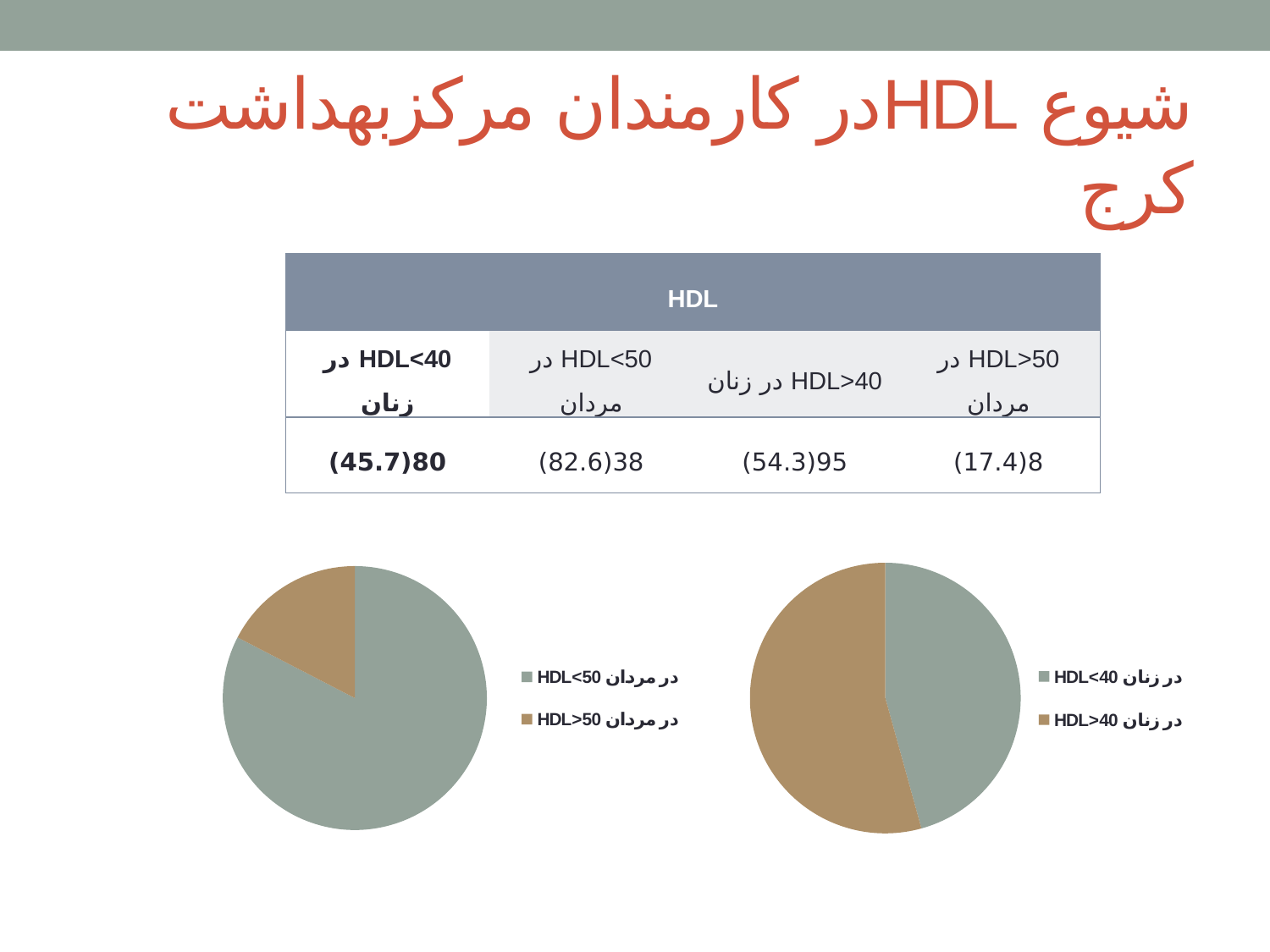
In the right pie chart, which category has the largest slice? HDL>40 در زنان How many charts are shown on the slide? 2 In the right pie chart, what colour is the slice for HDL<40 در زنان? green In the left pie chart, which slice is larger: HDL<50 در مردان or HDL>50 در مردان? HDL<50 در مردان In the left pie chart, how many slices are there? 2 In the right pie chart, how many entries does the legend list? 2 What kind of chart is the chart on the right of the slide? pie chart In the right pie chart, which slice is larger: HDL<40 در زنان or HDL>40 در زنان? HDL>40 در زنان In the left pie chart, which category has the smallest slice? HDL>50 در مردان What kind of chart is the chart on the left of the slide? pie chart In the left pie chart, is the share of HDL<50 در مردان greater or less than 50%? greater In the left pie chart, what colour is the slice for HDL>50 در مردان? brown